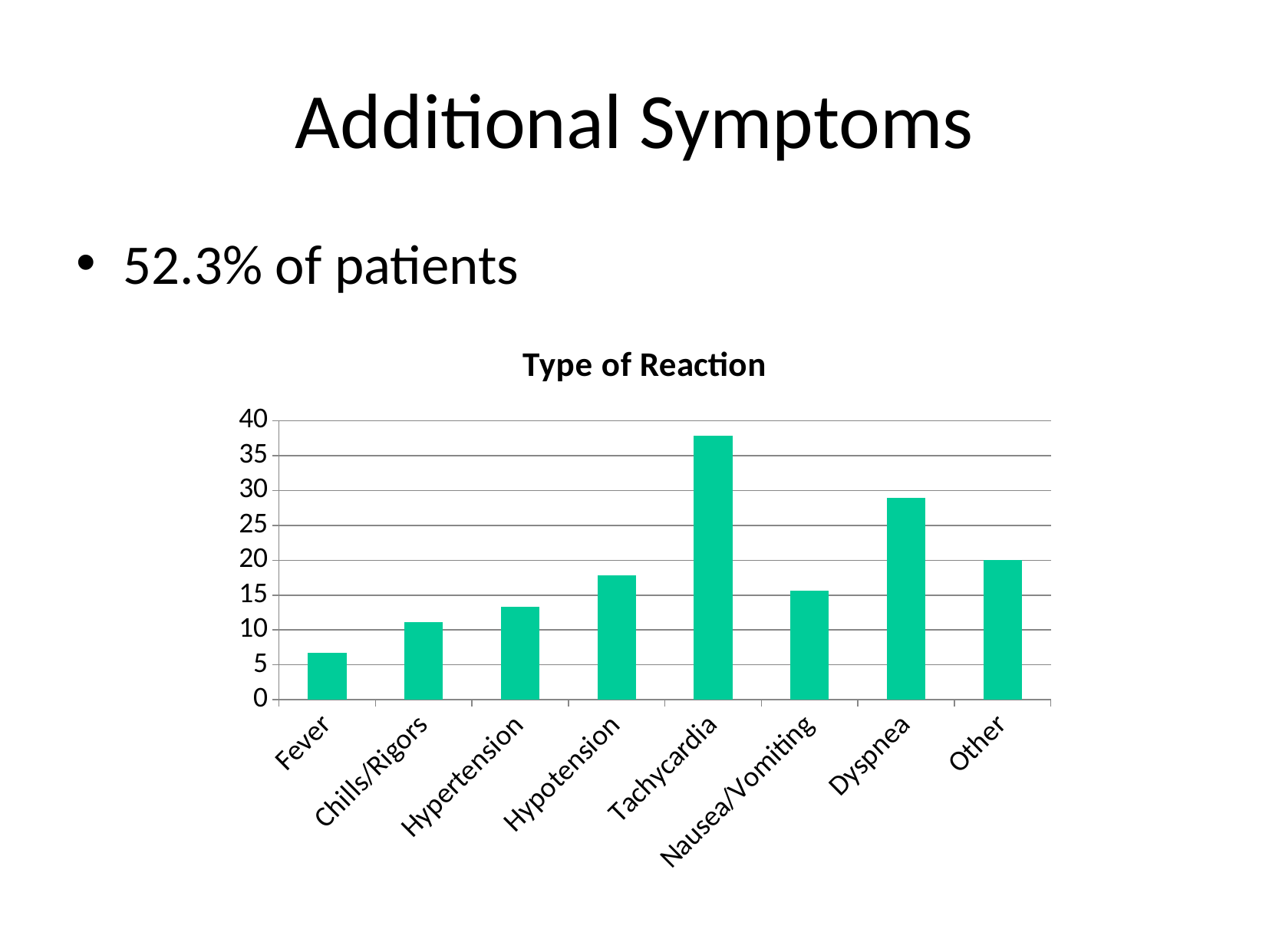
Is the value for Hypertension greater or less than 10? greater Which type of reaction has the highest value? Tachycardia Is the value for Tachycardia greater or less than 35? greater Which has a larger value, Nausea/Vomiting or Chills/Rigors? Nausea/Vomiting What is the title of the chart? Type of Reaction Which has a larger value, Dyspnea or Hypotension? Dyspnea How many reaction categories are shown on the x axis? 8 Is the value for Fever greater or less than 10? less What type of chart is shown on the slide? bar chart Which type of reaction has the lowest value? Fever